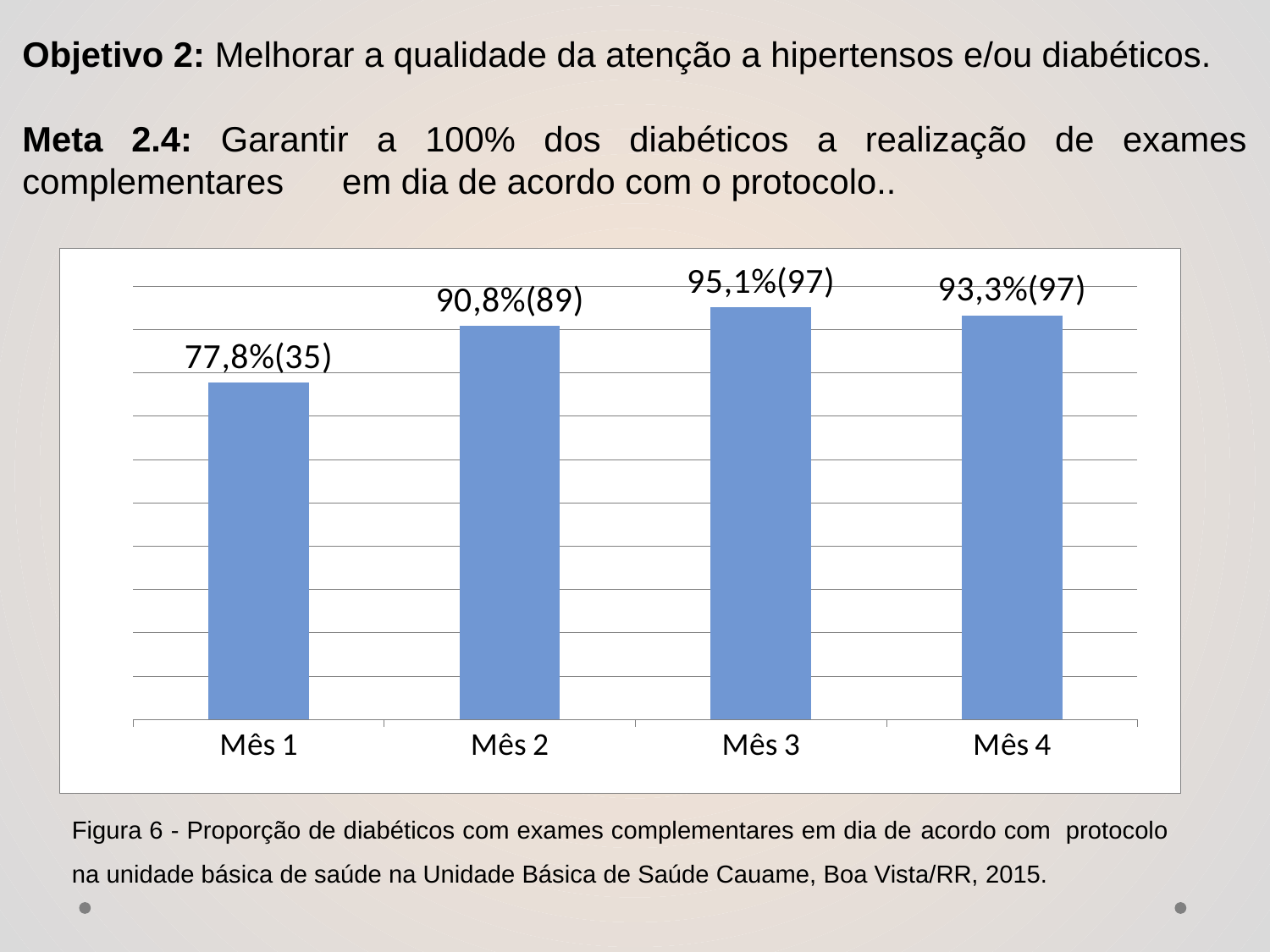
How many months are shown on the x axis? 4 Does the percentage rise or fall from Mês 1 to Mês 3? Rise Which month has the highest percentage? Mês 3 What percentage is shown for Mês 4? 93,3% What value is shown for Mês 3? 95,1%(97) What kind of chart is this? Bar chart What is the difference in percentage points between Mês 3 and Mês 1? 17,3 Which month has the lowest percentage? Mês 1 What percentage is shown for Mês 2? 90,8% What is the difference in percentage points between Mês 4 and Mês 2? 2,5 Which is larger, the percentage for Mês 2 or for Mês 4? Mês 4 What value is shown for Mês 1? 77,8%(35)